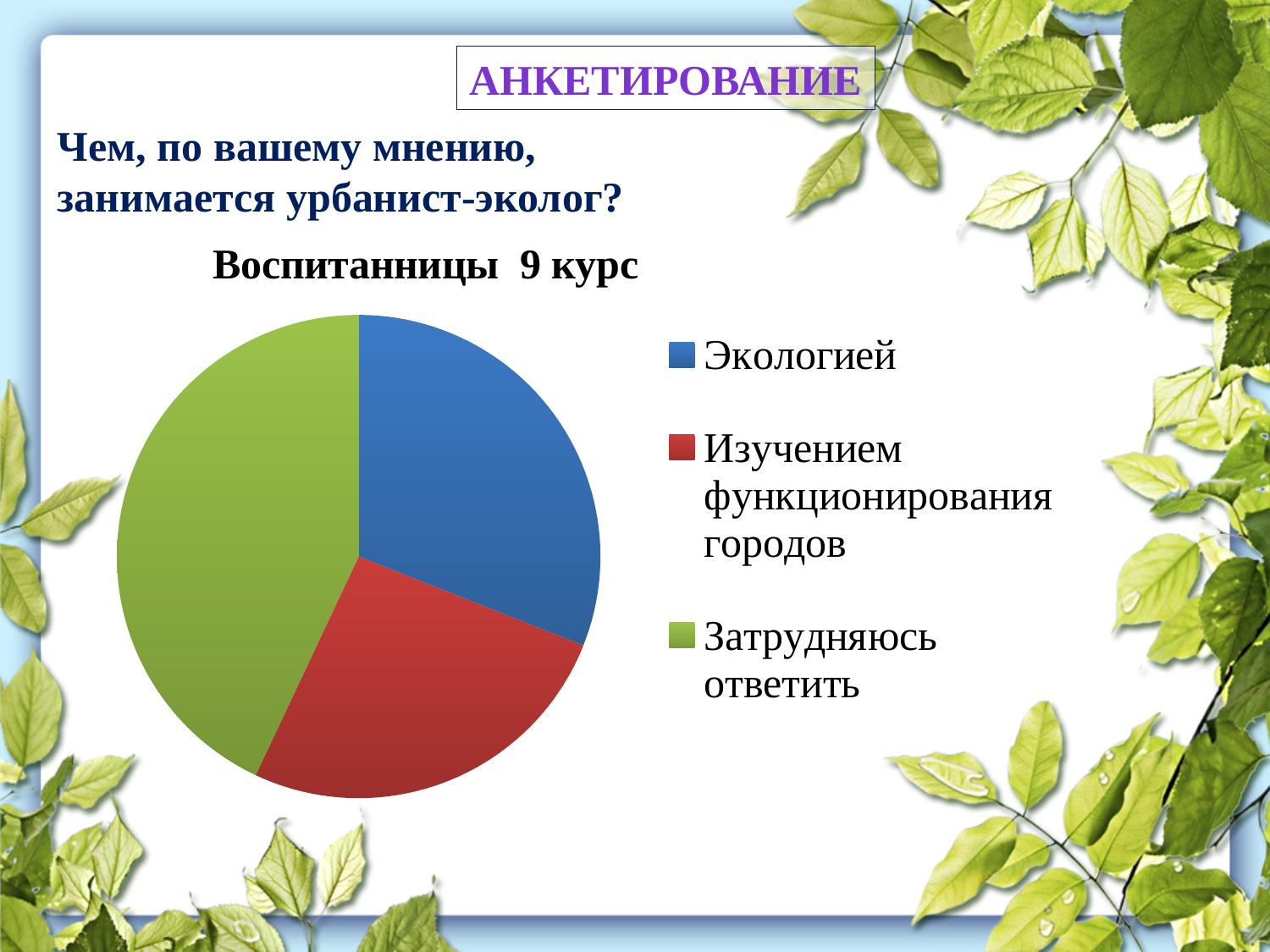
Which category has the smallest slice in the pie chart? Изучением функционирования городов Which colour represents Затрудняюсь ответить in the pie chart? green How many slices does the pie chart have? 3 Which category has the largest slice in the pie chart? Затрудняюсь ответить What kind of chart is shown on the slide? pie chart Which slice is larger: Экологией or Изучением функционирования городов? Экологией What is the title of the pie chart? Воспитанницы 9 курс How many entries does the legend of the pie chart list? 3